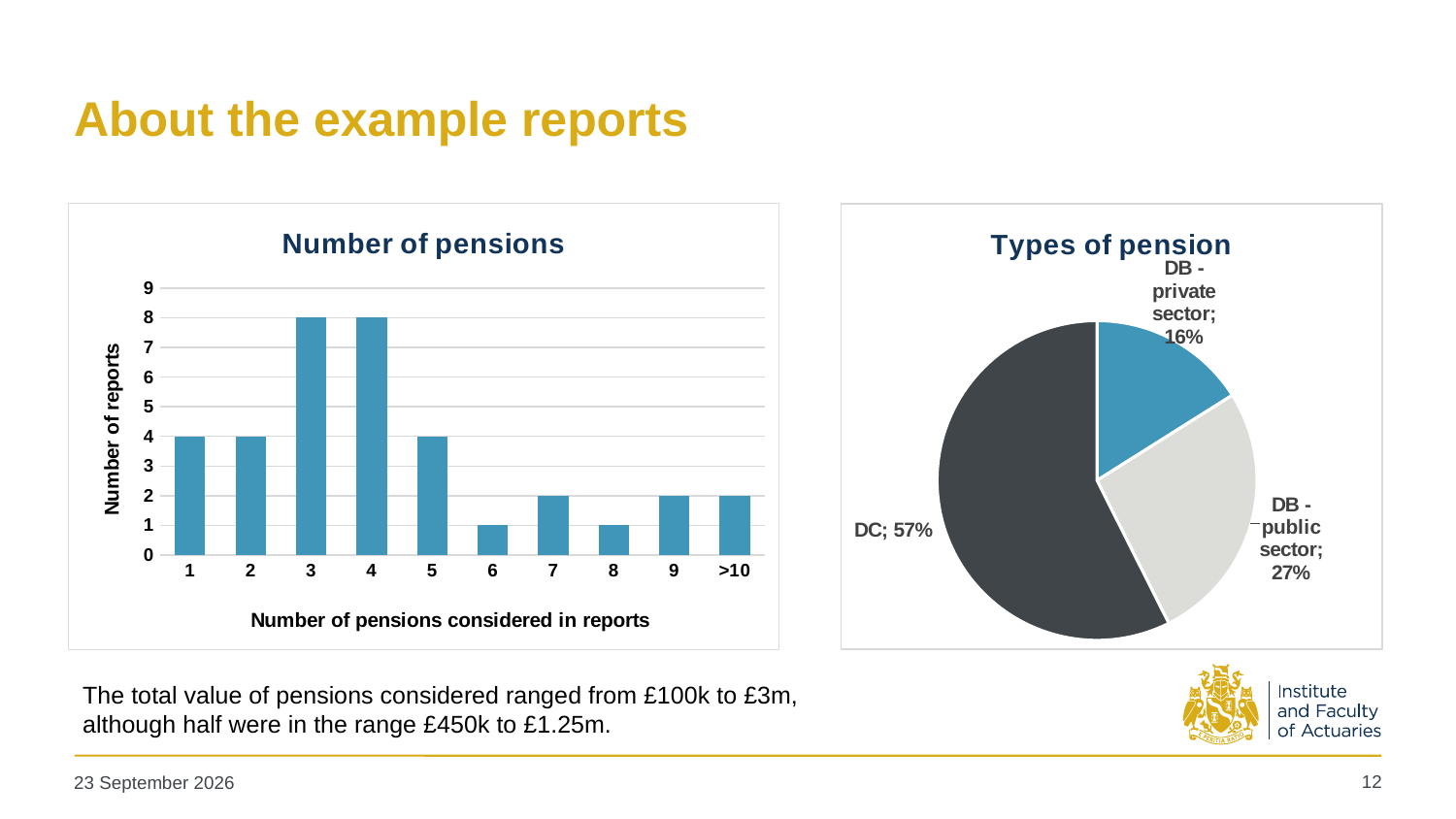
In the 'Number of pensions' chart, how many reports considered more than 10 pensions? 2 In the 'Number of pensions' chart, how many reports considered 6 pensions? 1 In the 'Number of pensions' chart, how many reports considered 3 pensions? 8 What type of chart is the 'Number of pensions' chart? Bar chart In the 'Number of pensions' chart, which has more reports: 1 pension or 7 pensions? 1 pension In the 'Types of pension' pie chart, what is the difference in percentage points between DB - public sector and DB - private sector? 11 In the 'Types of pension' pie chart, which type has the largest share? DC In the 'Types of pension' pie chart, what share is DB - private sector? 16% In the 'Number of pensions' chart, what is the difference between the number of reports considering 4 pensions and the number considering 5 pensions? 4 What is the y-axis label of the 'Number of pensions' chart? Number of reports In the 'Types of pension' pie chart, what share is DC? 57% How many categories are shown on the x axis of the 'Number of pensions' chart? 10